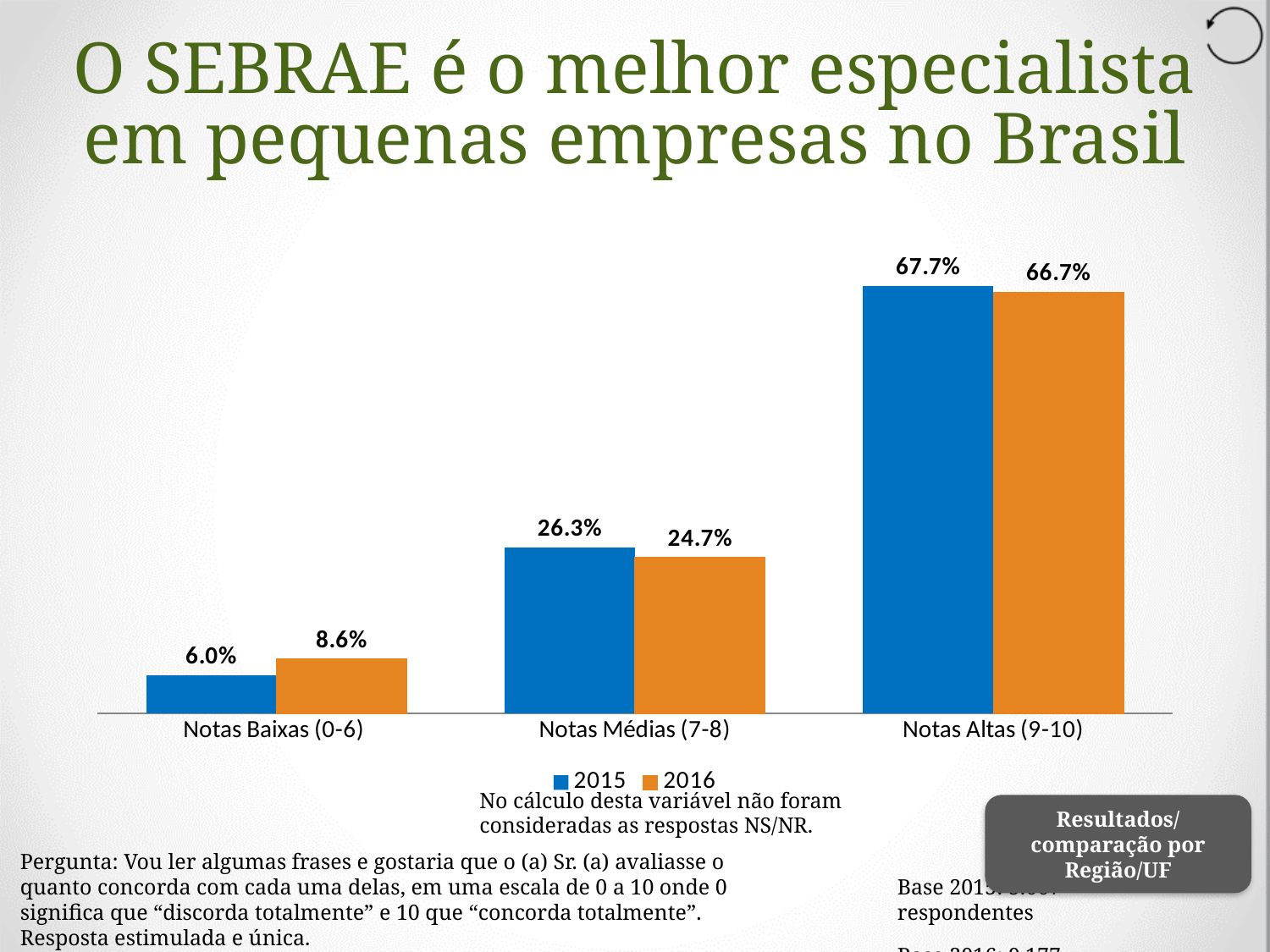
How many series does the legend list? 2 Which category has the lowest value in the 2016 series? Notas Baixas (0-6) What kind of chart is shown on the slide? Bar chart What is the value for Notas Altas (9-10) in the 2016 series? 66.7% How many categories are shown on the x axis? 3 What is the difference between the 2015 and 2016 values for Notas Baixas (0-6)? 2.6% For Notas Médias (7-8), which series has the larger value, 2015 or 2016? 2015 What is the value for Notas Médias (7-8) in the 2016 series? 24.7% For Notas Baixas (0-6), which series has the larger value, 2015 or 2016? 2016 What is the value for Notas Baixas (0-6) in the 2015 series? 6.0% What is the difference between the 2015 and 2016 values for Notas Médias (7-8)? 1.6% Which category has the highest value in the 2015 series? Notas Altas (9-10)